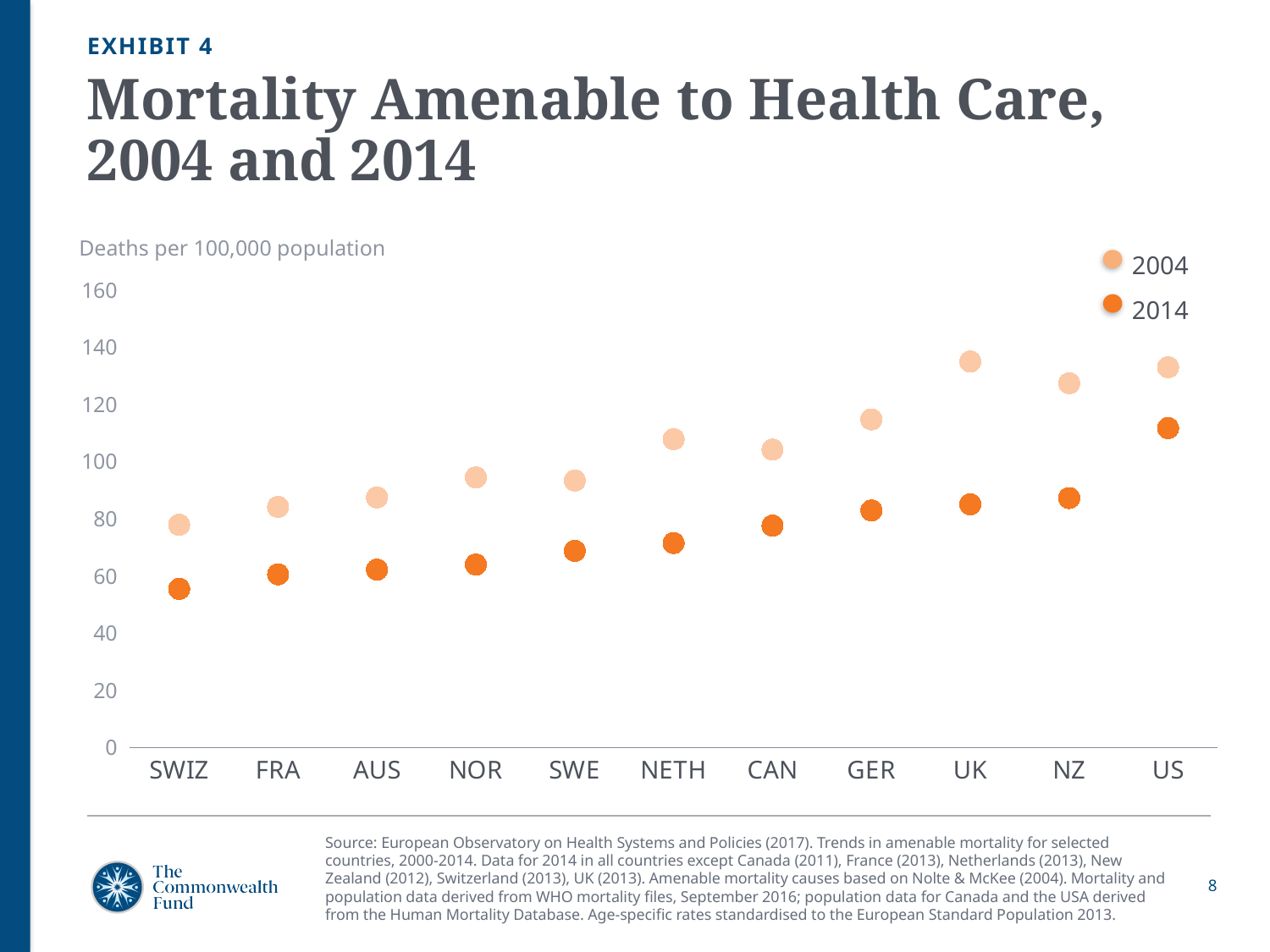
How many countries are shown on the x axis? 11 Which country has the highest 2014 value? US Which country has the lowest 2014 value? SWIZ Is the 2014 value for SWIZ greater or less than 60? less What unit is given for the values on the chart? Deaths per 100,000 population For Germany, which is larger: the 2004 value or the 2014 value? 2004 Is the 2004 value for the UK greater or less than 120? greater Do the 2014 values generally rise or fall moving from SWIZ to US along the x axis? rise Which country has the lowest 2004 value? SWIZ Is the 2014 value for the US greater or less than 100? greater How many series does the legend list? 2 What kind of chart is shown on the slide? Scatter (dot) chart